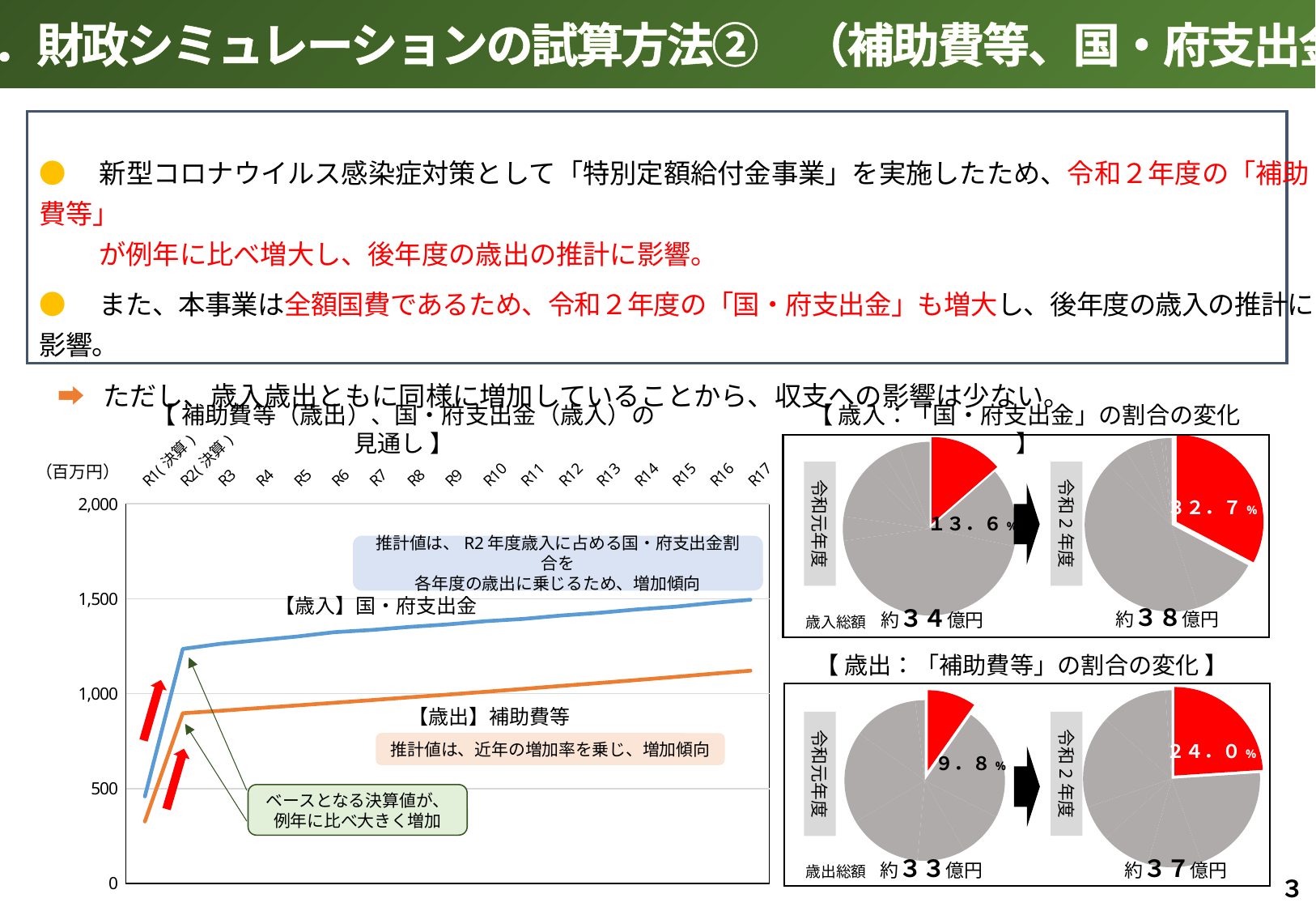
In the pie charts 【歳入：「国・府支出金」の割合の変化】, what share does 国・府支出金 have in 令和2年度? 32.7% In the line chart 【補助費等（歳出）、国・府支出金（歳入）の見通し】, how many lines are plotted? 2 In the line chart 【補助費等（歳出）、国・府支出金（歳入）の見通し】, is the value of 【歳出】補助費等 at R17 greater or less than 1,000? greater In the pie charts 【歳出：「補助費等」の割合の変化】, what is the 歳出総額 shown for 令和2年度? 約37億円 In the line chart 【補助費等（歳出）、国・府支出金（歳入）の見通し】, how many years are shown on the x axis (R1 through R17)? 17 In the pie charts 【歳入：「国・府支出金」の割合の変化】, by how many percentage points did the share of 国・府支出金 increase from 令和元年度 (13.6%) to 令和2年度 (32.7%)? 19.1 percentage points In the line chart 【補助費等（歳出）、国・府支出金（歳入）の見通し】, do the values of 【歳入】国・府支出金 rise or fall from R2(決算) to R17? rise In the line chart 【補助費等（歳出）、国・府支出金（歳入）の見通し】, is the value of 【歳入】国・府支出金 at R2(決算) greater or less than 1,000? greater In the line chart 【補助費等（歳出）、国・府支出金（歳入）の見通し】, which line is higher at R17, 【歳入】国・府支出金 or 【歳出】補助費等? 【歳入】国・府支出金 In the line chart 【補助費等（歳出）、国・府支出金（歳入）の見通し】, is the value of 【歳出】補助費等 at R1(決算) greater or less than 500? less What kind of chart is the chart titled 【補助費等（歳出）、国・府支出金（歳入）の見通し】? line chart In the pie charts 【歳出：「補助費等」の割合の変化】, what share does 補助費等 have in 令和元年度? 9.8%